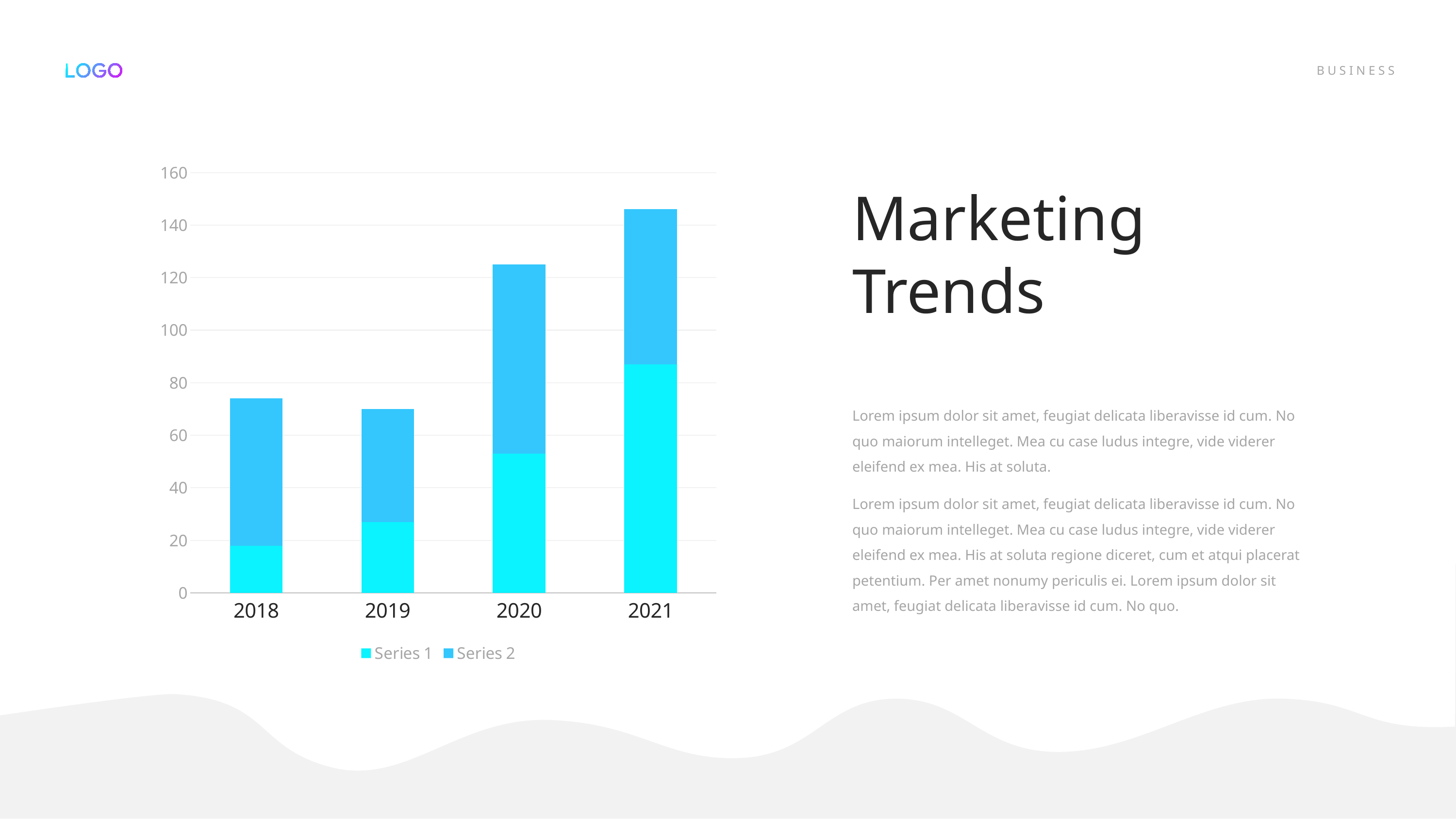
Is the total stacked value for 2021 greater or less than 140? greater Is the Series 1 value for 2021 greater or less than 80? greater Which year has the larger total stacked bar, 2019 or 2020? 2020 Which year has the smallest Series 2 segment? 2019 What kind of chart is shown on the slide? Stacked bar chart Which year has the largest Series 2 segment? 2020 How many years are shown on the x axis? 4 Does the Series 1 value rise or fall from 2018 to 2021? rise Which year has the tallest stacked bar overall? 2021 How many series does the legend list? 2 Which year has the smallest Series 1 segment? 2018 Is the total stacked value for 2018 greater or less than 80? less